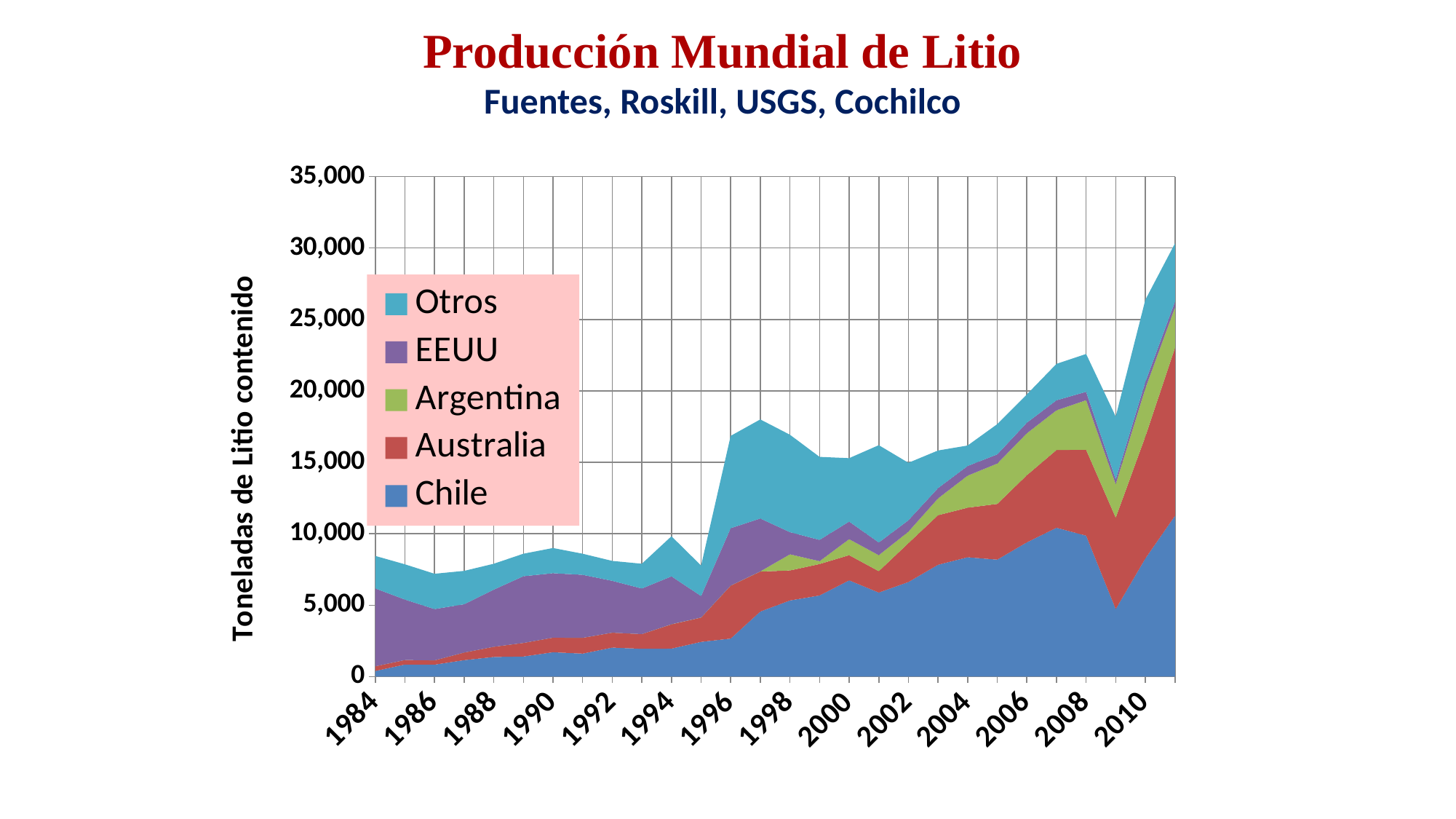
Is the total world production in 1997 greater or less than 15,000? greater What kind of chart is shown on the slide? Stacked area chart Does total world lithium production generally rise or fall from 1984 to 2011? rise Is the total world production in 2008 greater or less than 20,000? greater Which is larger, the total world production in 2011 or in 1984? 2011 Is the total world production in 1990 greater or less than 10,000? less What is the title of the chart? Producción Mundial de Litio How many series does the legend list? 5 What is the label on the vertical axis? Toneladas de Litio contenido